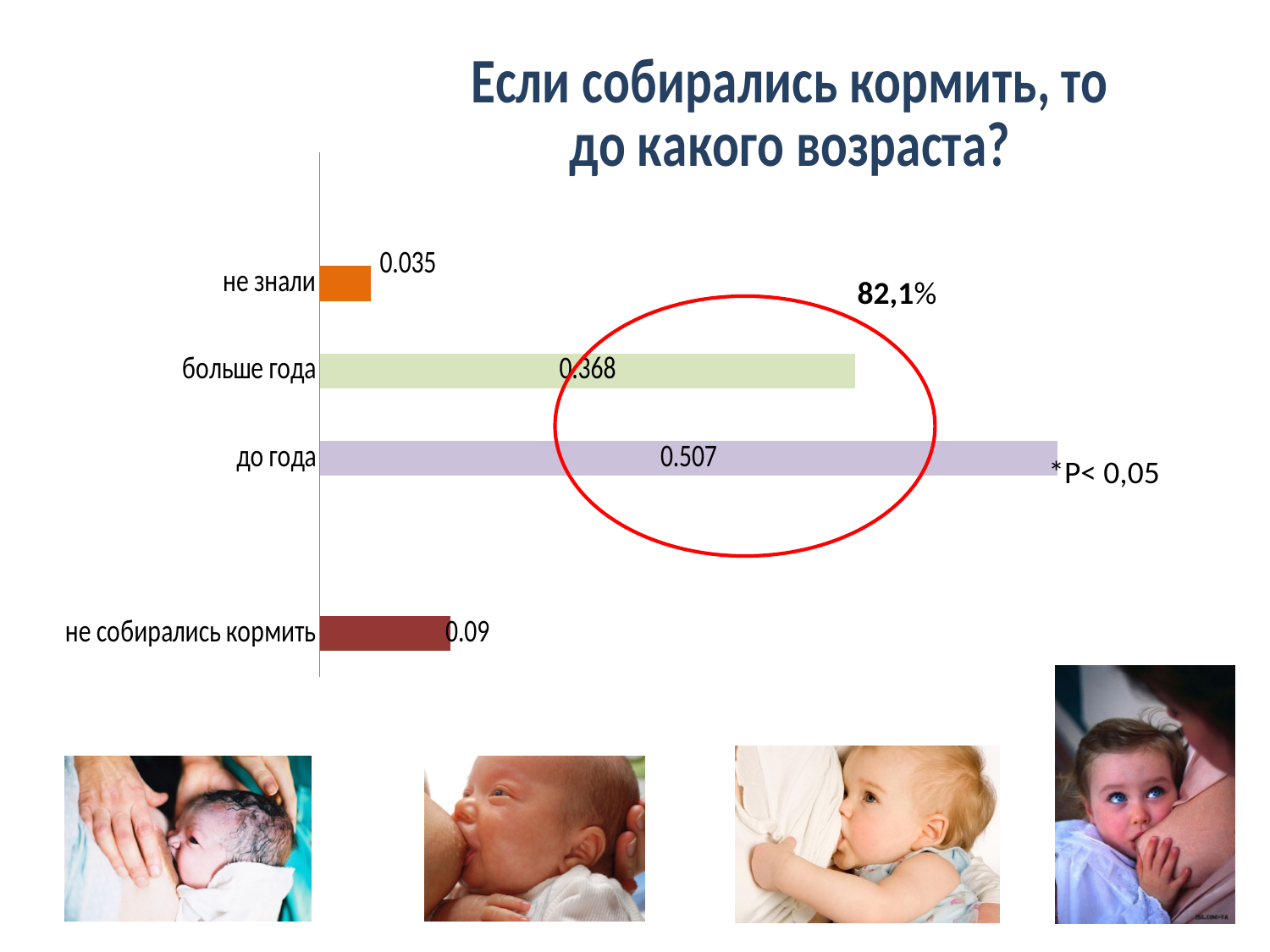
Which is larger, the value for "не собирались кормить" or the value for "не знали"? не собирались кормить What is the value for "до года"? 0.507 Which category has the highest value? до года What percentage is written in bold next to the red circle on the chart? 82,1% How many categories are shown in the chart? 4 Which category has the lowest value? не знали What is the value for "не собирались кормить"? 0.09 What is the value for "больше года"? 0.368 What is the difference between the values for "до года" and "больше года"? 0.139 What is the title of the chart? Если собирались кормить, то до какого возраста? What kind of chart is shown on the slide? bar chart What is the value for "не знали"? 0.035